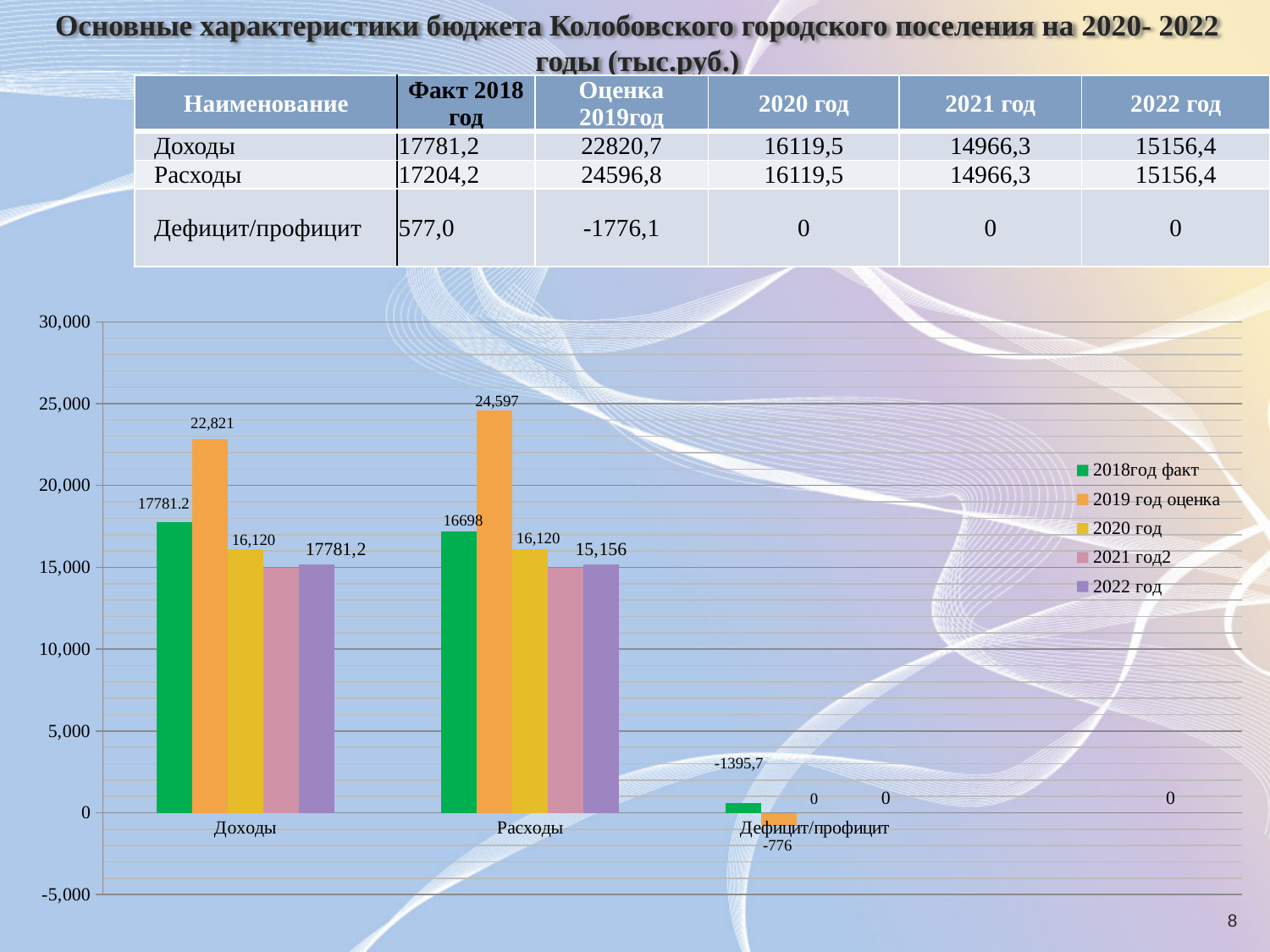
How many series does the chart legend list? 5 What is the value of the 2019 год оценка bar for Доходы? 22,821 How many categories are shown along the x axis of the chart? 3 What is the difference between the 2019 год оценка bars for Расходы and Доходы? 1,776 What is the value of the 2020 год bar for Расходы? 16,120 What kind of chart is shown on the slide? bar chart Which is larger: the 2019 год оценка bar for Доходы or for Расходы? Расходы Is the 2018год факт bar for Доходы greater or less than 15,000? greater What is the value of the 2019 год оценка bar for Расходы? 24,597 Which category has the tallest 2019 год оценка bar? Расходы Is the 2019 год оценка bar for Расходы greater or less than 25,000? less Which legend entry is shown in orange? 2019 год оценка